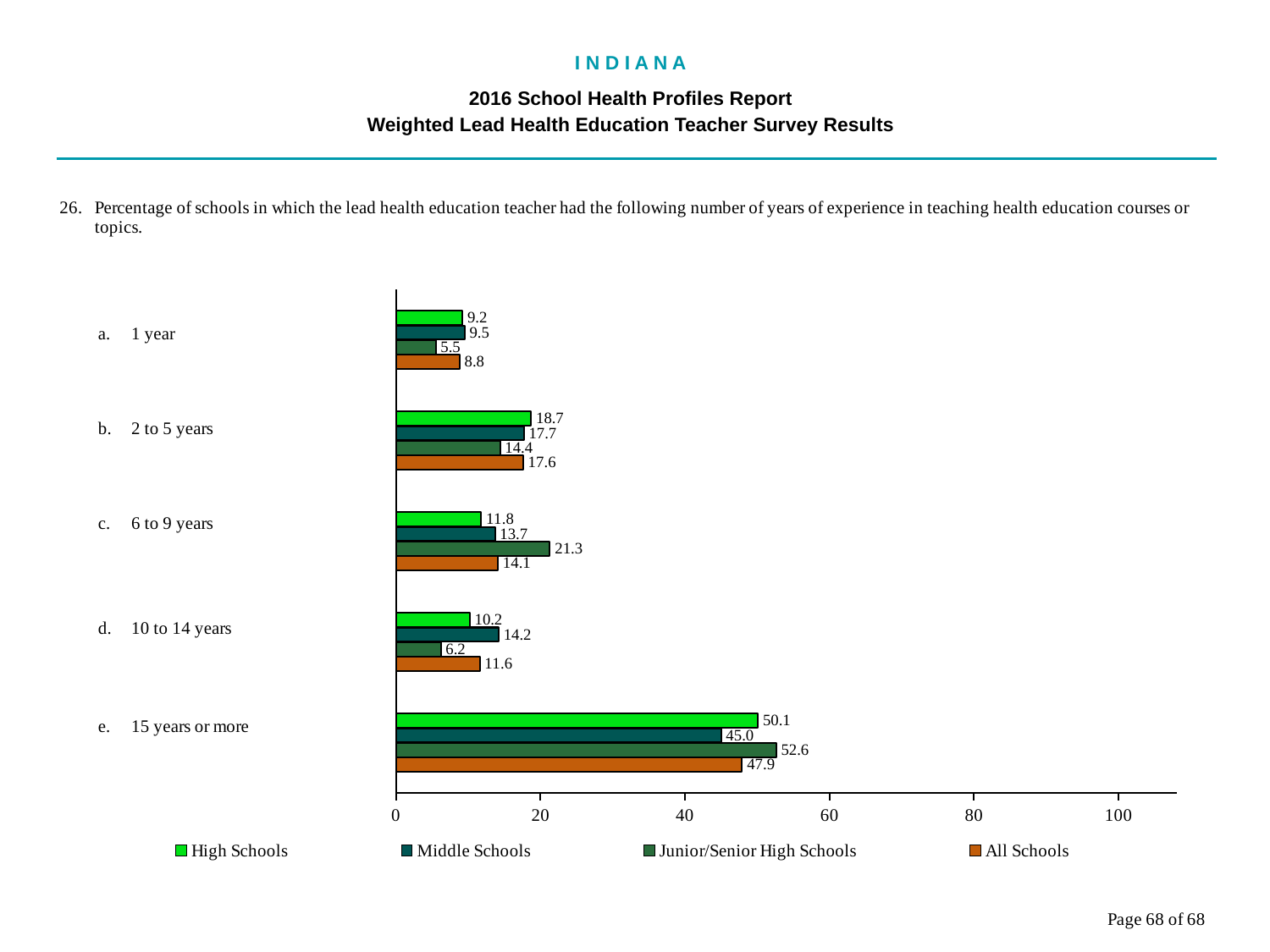
Which category has the highest value for All Schools? 15 years or more What is the value for All Schools in the '2 to 5 years' category? 17.6 What is the value for High Schools in the '15 years or more' category? 50.1 How many series does the legend list? 4 How many categories of years of experience are shown on the chart? 5 What kind of chart is shown on the slide? Bar chart What is the value for Middle Schools in the '10 to 14 years' category? 14.2 What is the difference between the Junior/Senior High Schools and Middle Schools values in the '15 years or more' category? 7.6 Which category has the lowest value for Junior/Senior High Schools? 1 year Which is larger in the '6 to 9 years' category: the High Schools value or the Junior/Senior High Schools value? Junior/Senior High Schools What is the value for Junior/Senior High Schools in the '6 to 9 years' category? 21.3 Is the value for All Schools in the '15 years or more' category greater or less than 40? greater